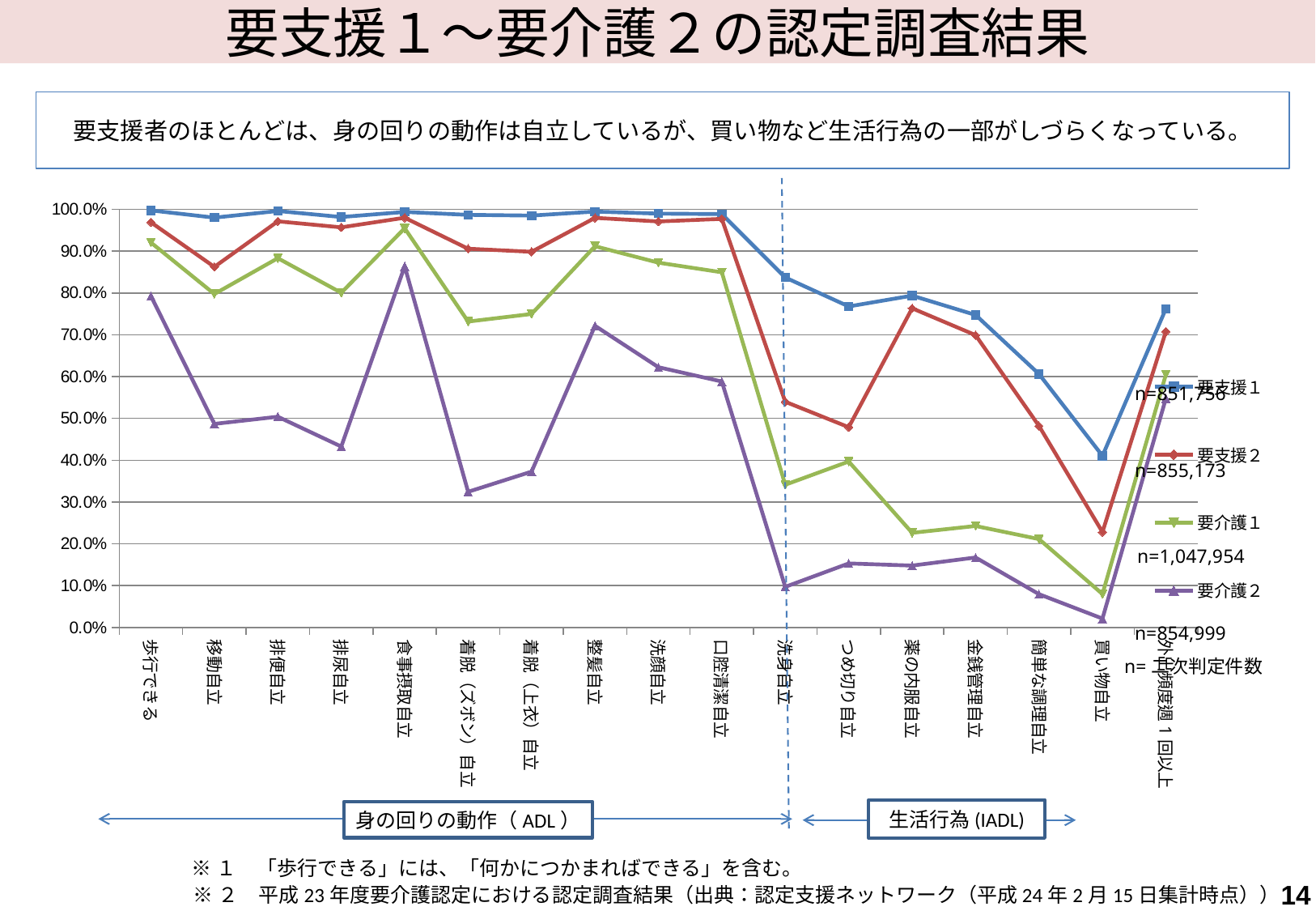
Is the value for 要介護2 at 食事摂取自立 greater or less than 80.0%? greater At 洗身自立, which series has the larger value, 要支援2 or 要介護1? 要支援2 Is the value for 要支援1 at 買い物自立 greater or less than 50.0%? less How many series does the legend list? 4 How many categories are plotted along the x axis? 17 What kind of chart is shown on the slide? line chart For the 要介護2 series, which category has the lowest value? 買い物自立 Does the 要介護2 line rise or fall from 簡単な調理自立 to 買い物自立? fall What n value is shown in the legend for 要介護1? n=1,047,954 Is the value for 要介護1 at 薬の内服自立 greater or less than 30.0%? less For the 要介護2 series, which category has the highest value? 食事摂取自立